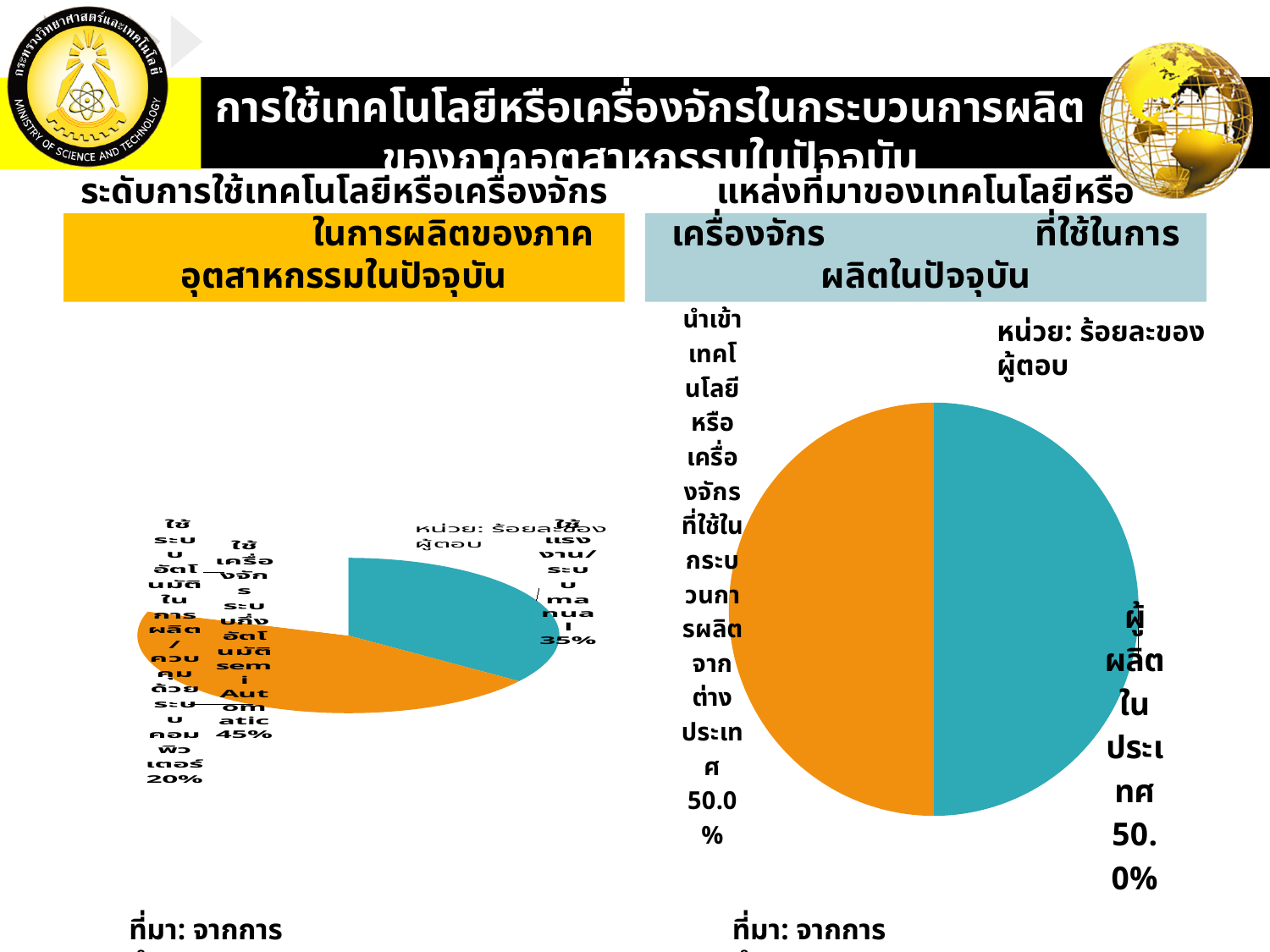
In the left chart, which category has the smallest share? ใช้ระบบอัตโนมัติในการผลิต/ควบคุมด้วยระบบคอมพิวเตอร์ In the right chart, how many slices does the pie have? 2 In the left chart, what is the difference in percentage points between semi Automatic and manual? 10 In the left chart, what percentage is shown for ใช้ระบบอัตโนมัติในการผลิต/ควบคุมด้วยระบบคอมพิวเตอร์? 20% In the left chart, what percentage is shown for ใช้เครื่องจักรระบบกึ่งอัตโนมัติ semi Automatic? 45% In the right chart (แหล่งที่มาของเทคโนโลยีหรือเครื่องจักรที่ใช้ในการผลิตในปัจจุบัน), what percentage is shown for ผู้ผลิตในประเทศ? 50.0% In the left chart, which category has the largest share? ใช้เครื่องจักรระบบกึ่งอัตโนมัติ semi Automatic What type of chart is the left chart? Pie chart In the right chart, what percentage is shown for นำเข้าเทคโนโลยีหรือเครื่องจักรที่ใช้ในกระบวนการผลิตจากต่างประเทศ? 50.0% In the left chart (ระดับการใช้เทคโนโลยีหรือเครื่องจักรในการผลิตของภาคอุตสาหกรรมในปัจจุบัน), what percentage is shown for ใช้แรงงาน/ระบบ manual? 35% What unit is stated for the values in the right chart? ร้อยละของผู้ตอบ In the left chart, how many slices does the pie have? 3